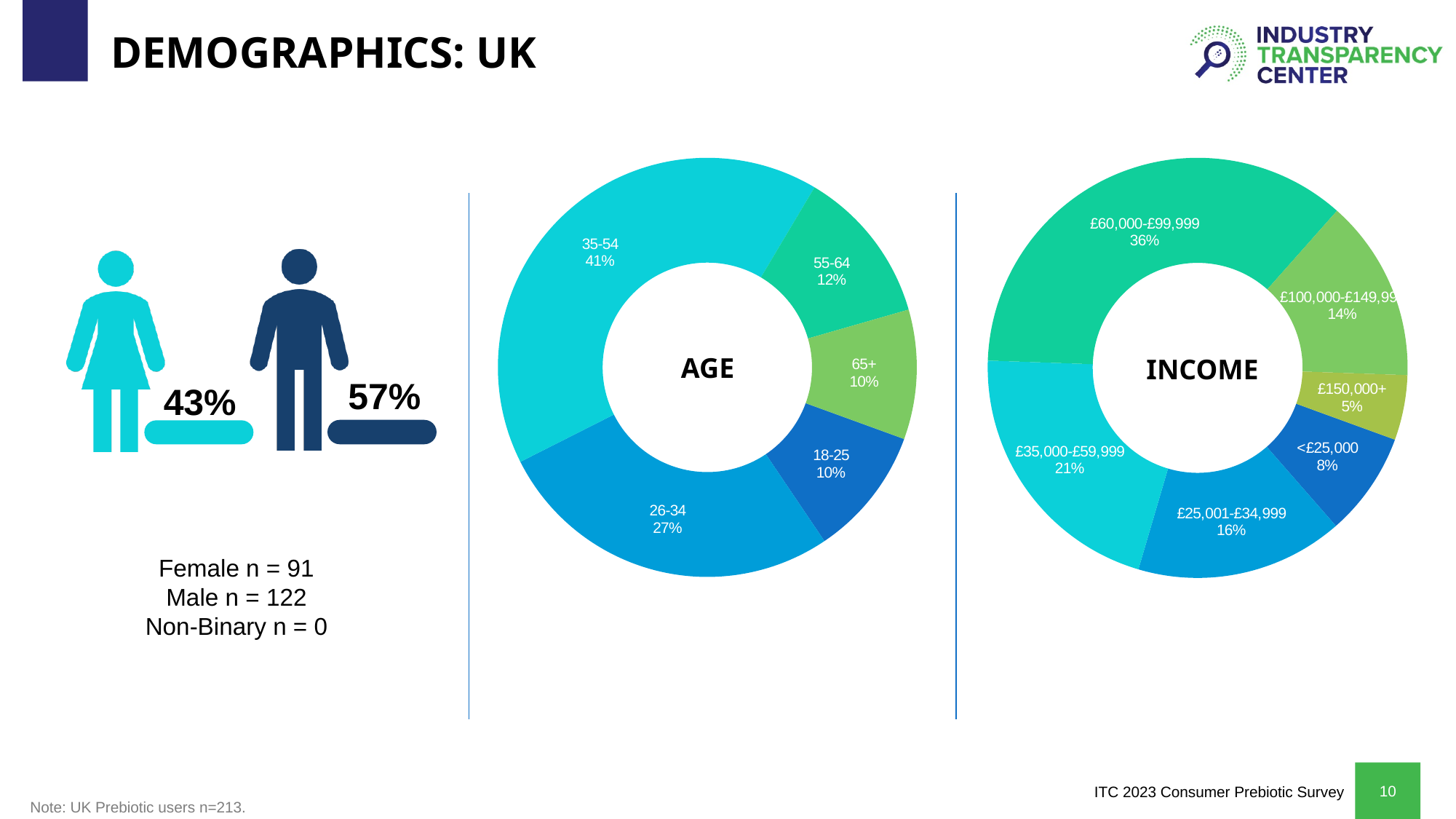
In the INCOME chart, what percentage is shown for £35,000-£59,999? 21% In the AGE chart, which is larger, the 55-64 share or the 65+ share? 55-64 In the AGE chart, what is the difference between the 35-54 share and the 26-34 share? 14% In the INCOME chart, how many income bands are shown? 6 In the INCOME chart, what is the difference between the £25,001-£34,999 share and the <£25,000 share? 8% In the INCOME chart, which income band has the smallest share? £150,000+ What kind of chart is the INCOME chart? Doughnut (pie) chart In the AGE chart, what percentage is shown for the 26-34 group? 27% In the AGE chart, which age group has the largest share? 35-54 In the AGE chart, how many age groups are shown? 5 In the INCOME chart, what share of respondents earn £60,000-£99,999? 36% In the AGE chart, what share of respondents are aged 35-54? 41%